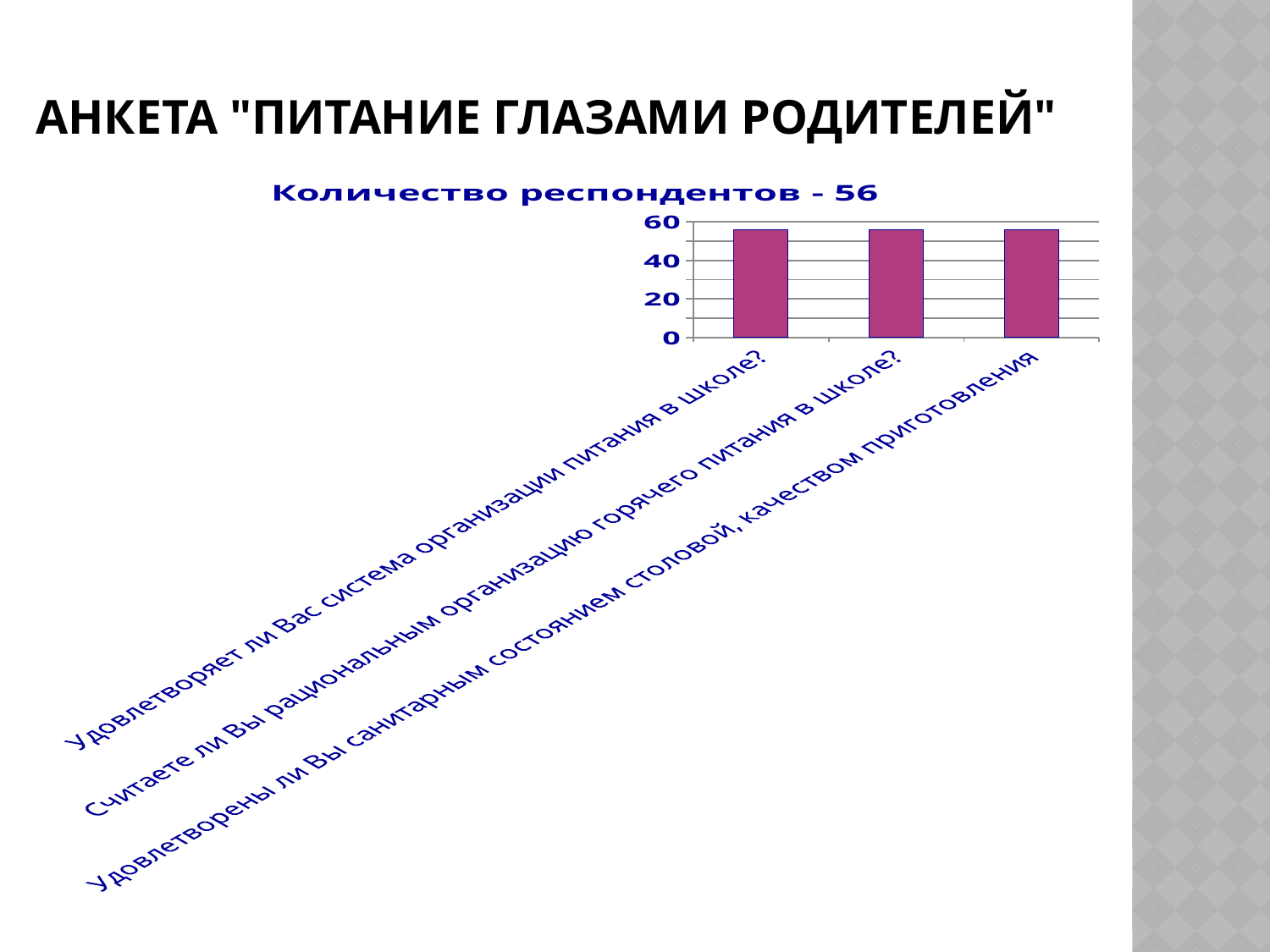
What is the label of the first (leftmost) category on the x axis? Удовлетворяет ли Вас система организации питания в школе? What is the label of the third (rightmost) category on the x axis? Удовлетворены ли Вы санитарным состоянием столовой, качеством приготовления Do the bar values rise, fall, or stay about the same from left to right? stay about the same What is the title of the chart? Количество респондентов - 56 How many bars (categories) does the chart show? 3 What is the highest tick value shown on the vertical axis? 60 Is the value for "Удовлетворяет ли Вас система организации питания в школе?" greater or less than 40? greater What kind of chart is shown on the slide? bar chart Is the value for "Удовлетворены ли Вы санитарным состоянием столовой, качеством приготовления" greater or less than 20? greater Is the value for "Считаете ли Вы рациональным организацию горячего питания в школе?" greater or less than 40? greater